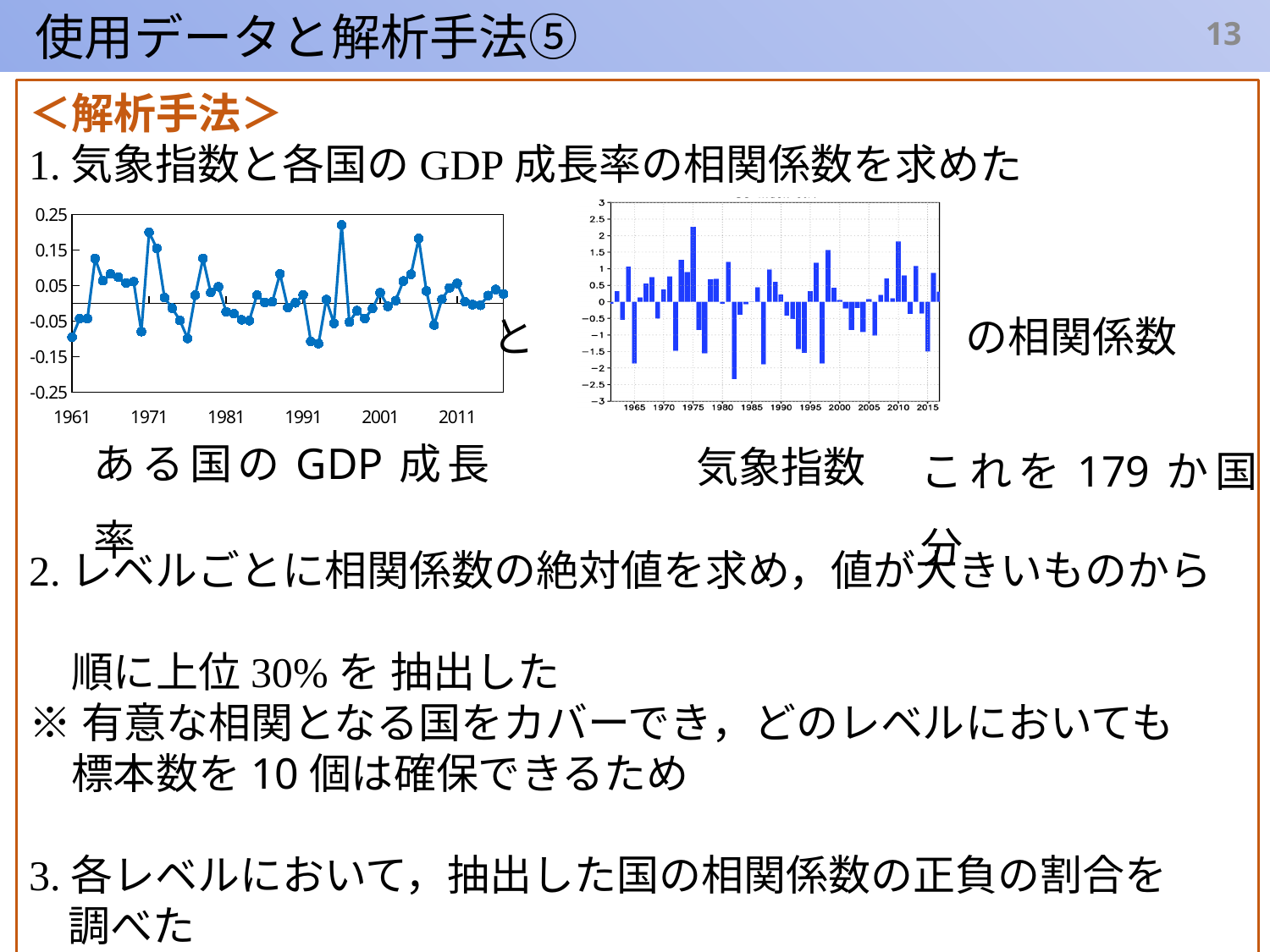
What is the caption written under the right chart? 気象指数 What is the last year labelled on the x axis of the right chart (気象指数)? 2015 In the left chart (ある国のGDP成長率), is the value at the first year, 1961, greater or less than -0.05? less What is the caption written under the left chart? ある国のGDP成長率 What is the first year labelled on the x axis of the left chart (ある国のGDP成長率)? 1961 In the right chart (気象指数), is the lowest bar greater or less than -1.5? less In the left chart (ある国のGDP成長率), is the highest point on the line greater or less than 0.15? greater What kind of chart is the right chart (気象指数)? bar chart What is the highest value labelled on the y axis of the left chart (ある国のGDP成長率)? 0.25 How many year labels are shown on the x axis of the left chart (ある国のGDP成長率)? 6 What kind of chart is the left chart (ある国のGDP成長率)? line chart